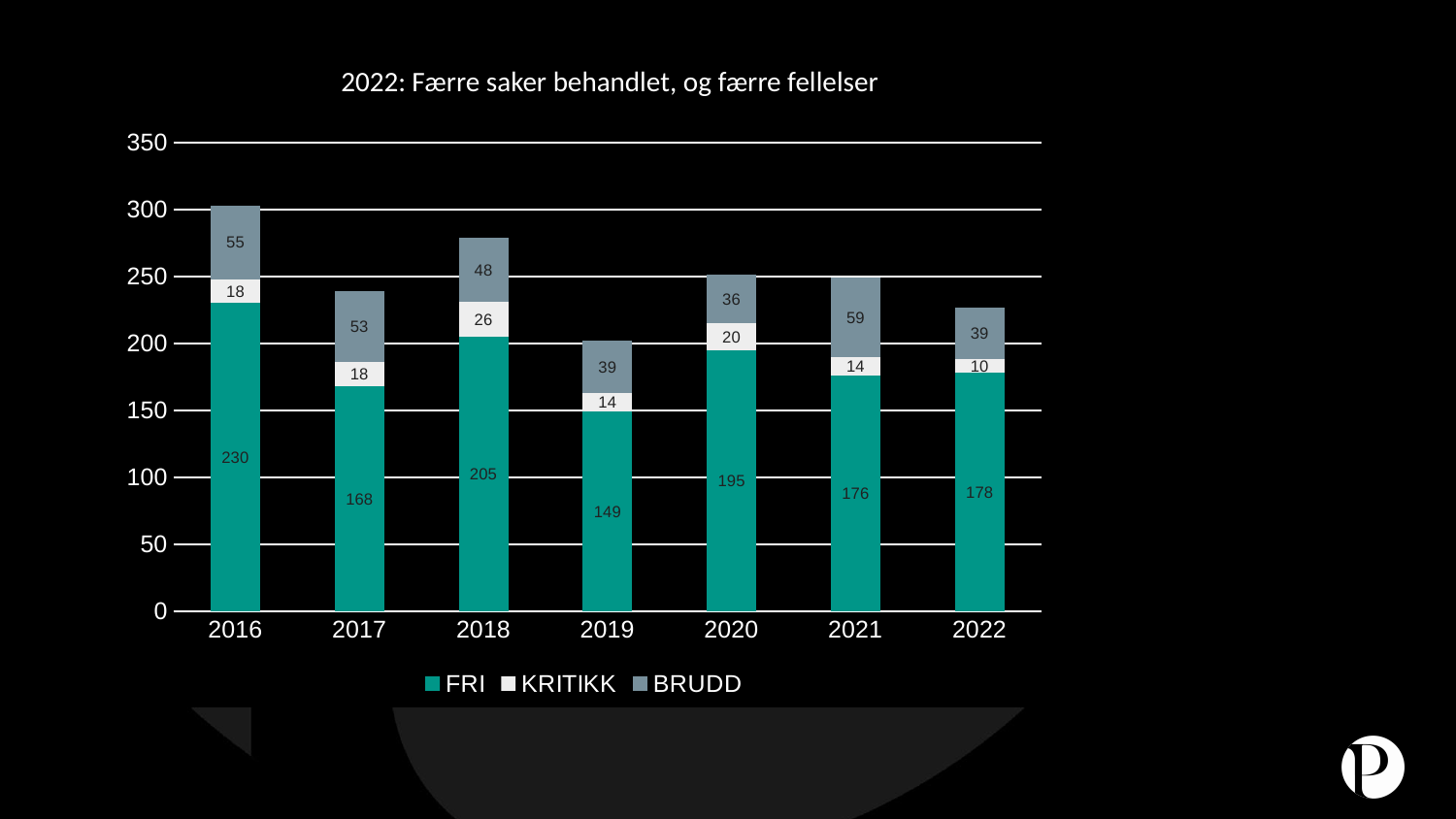
What is the FRI value for 2016? 230 How many series does the legend list? 3 Which year has the highest FRI value? 2016 Which is larger, the BRUDD value for 2018 or the BRUDD value for 2020? 2018 What is the KRITIKK value for 2022? 10 How many years are shown on the x axis? 7 Which year has the lowest FRI value? 2019 What kind of chart is shown on the slide? Stacked bar chart What is the difference between the FRI values for 2016 and 2017? 62 What is the total of the stacked bar for 2019? 202 What is the BRUDD value for 2021? 59 What is the total of the stacked bar for 2022? 227